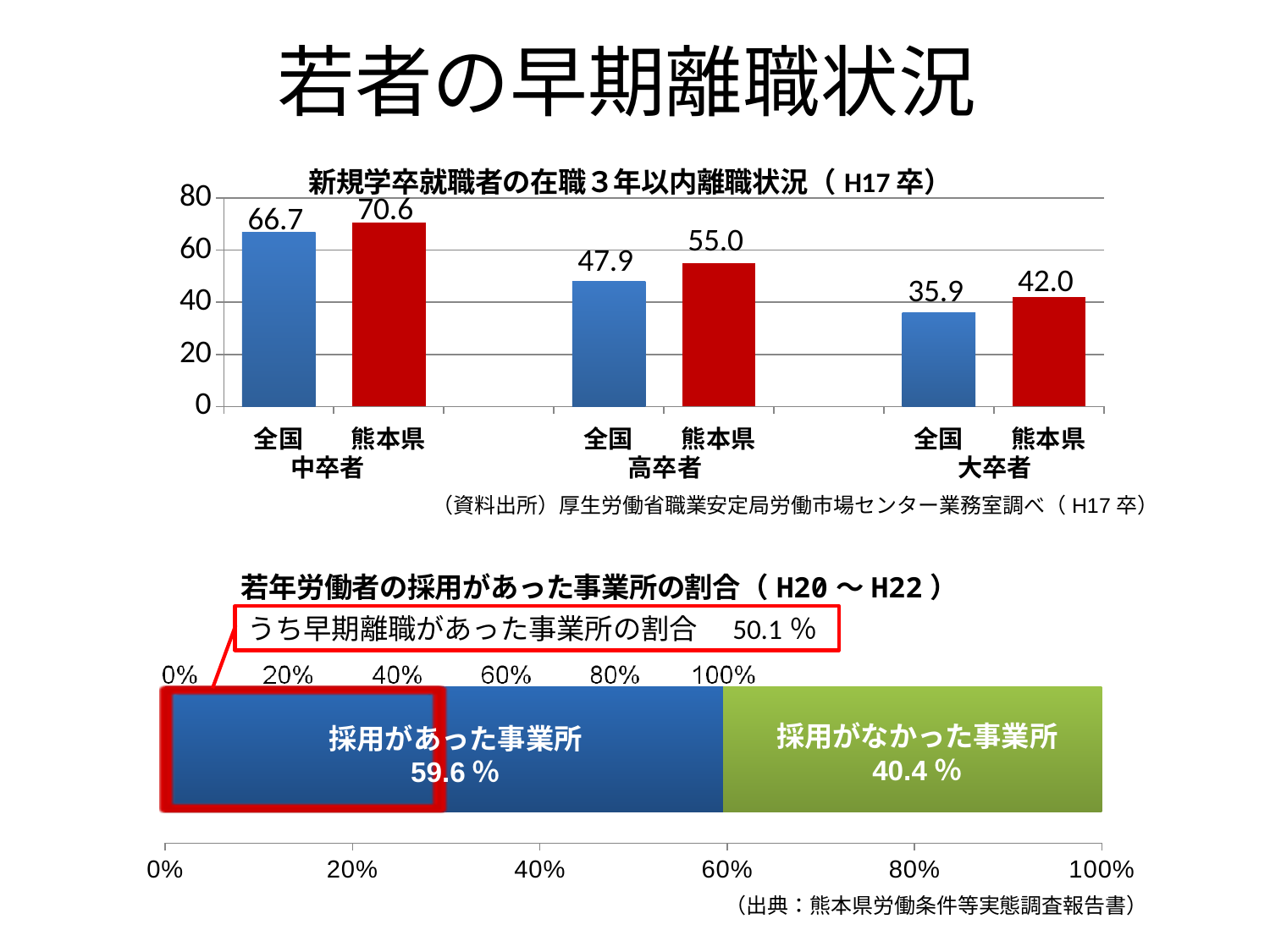
In the top chart (新規学卒就職者の在職３年以内離職状況), what is the value for 熊本県 among 大卒者? 42.0 In the top chart (新規学卒就職者の在職３年以内離職状況), which bar has the lowest value? 全国 大卒者 In the bottom chart (若年労働者の採用があった事業所の割合), what is the value for 採用がなかった事業所? 40.4％ What kind of chart is the top chart (新規学卒就職者の在職３年以内離職状況)? bar chart In the bottom chart (若年労働者の採用があった事業所の割合), what is the total of the two segments of the stacked bar? 100％ In the top chart (新規学卒就職者の在職３年以内離職状況), what is the value for 熊本県 among 中卒者? 70.6 In the top chart (新規学卒就職者の在職３年以内離職状況), which bar has the highest value? 熊本県 中卒者 In the top chart (新規学卒就職者の在職３年以内離職状況), what is the difference between 熊本県 and 全国 among 高卒者? 7.1 In the top chart (新規学卒就職者の在職３年以内離職状況), how many bars are plotted? 6 In the top chart (新規学卒就職者の在職３年以内離職状況), what is the value for 全国 among 高卒者? 47.9 In the top chart (新規学卒就職者の在職３年以内離職状況), which is larger among 大卒者: 全国 or 熊本県? 熊本県 In the top chart (新規学卒就職者の在職３年以内離職状況), do the 全国 values rise or fall from 中卒者 to 大卒者? fall